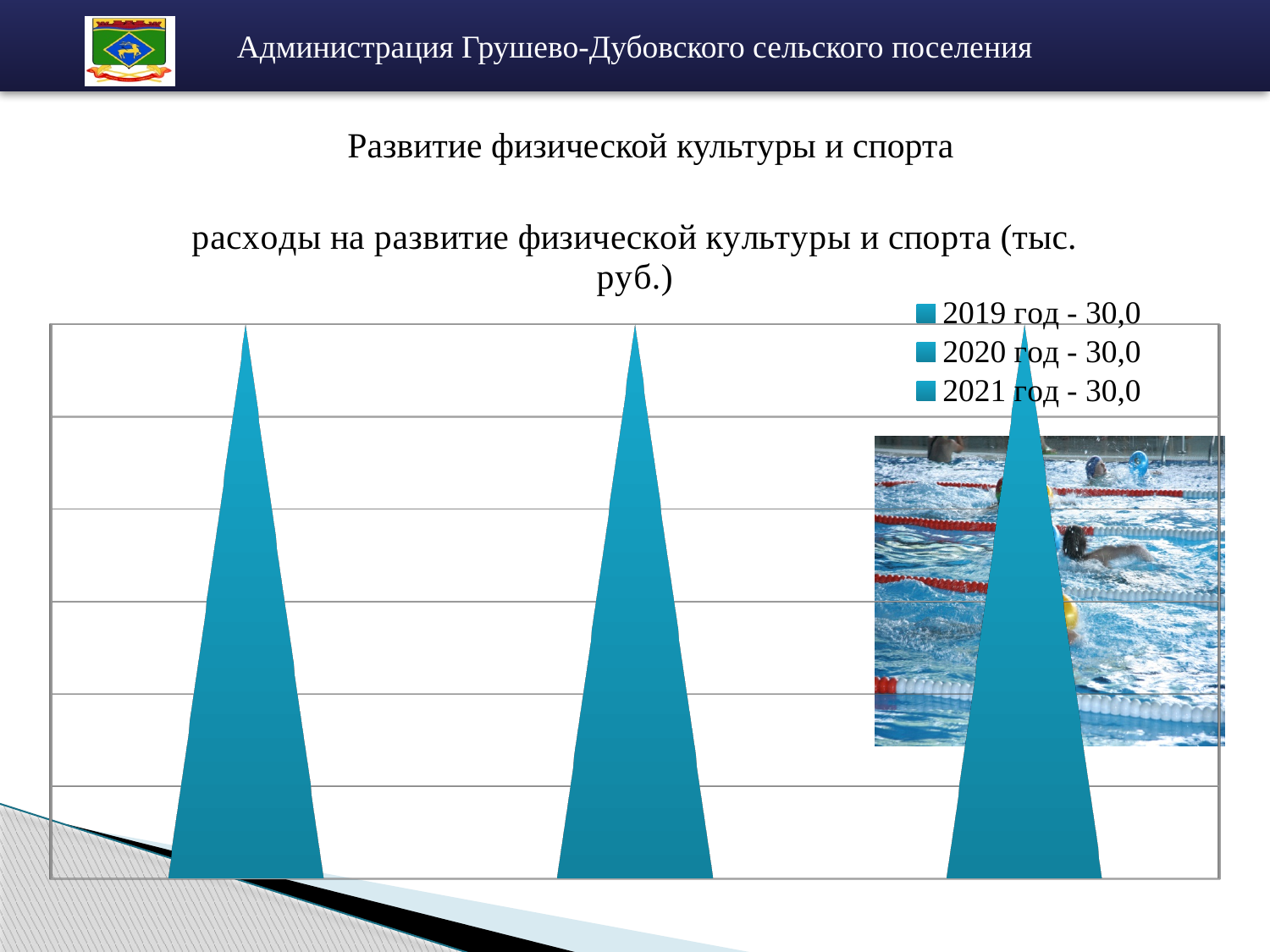
What is the value for 2021 год in the chart? 30,0 What is the difference between the values for 2019 год and 2021 год? 0,0 Do the values rise, fall or stay the same from 2019 год to 2021 год? stay the same How many bars are plotted in the chart? 3 What colour are the bars in the chart? blue How many entries does the chart's legend list? 3 What kind of chart is shown on the slide? bar chart What is the title of the chart? расходы на развитие физической культуры и спорта (тыс. руб.) What is the value for 2019 год in the chart? 30,0 What is the value for 2020 год in the chart? 30,0